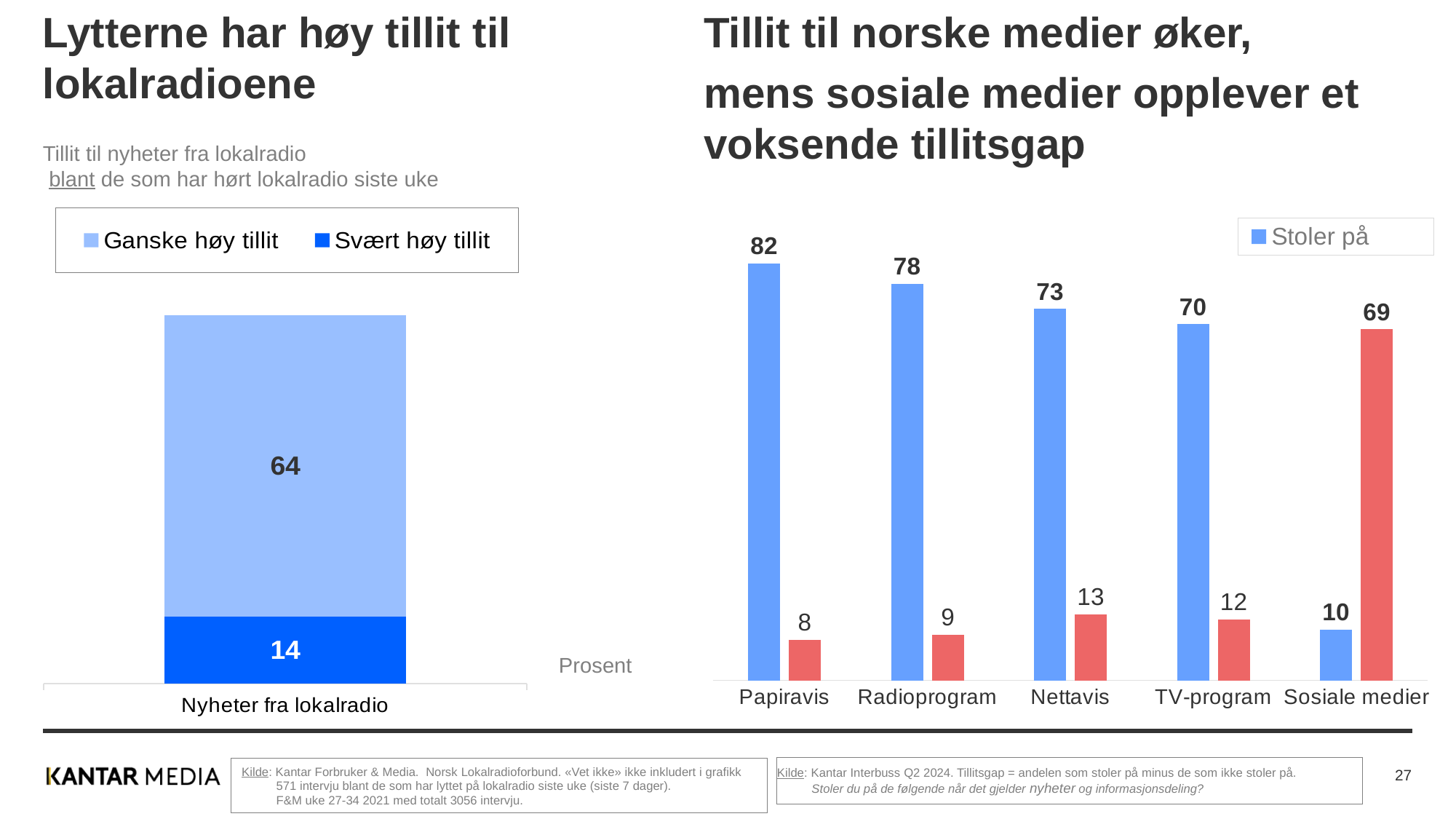
In the right chart (Tillit til norske medier øker), which category has the highest Stoler på value? Papiravis In the left chart (Tillit til nyheter fra lokalradio), what is the value for Ganske høy tillit? 64 In the right chart (Tillit til norske medier øker), how many categories are shown on the x axis? 5 In the left chart (Tillit til nyheter fra lokalradio), how many series does the legend list? 2 In the left chart (Tillit til nyheter fra lokalradio), what is the value for Svært høy tillit? 14 In the right chart (Tillit til norske medier øker), what is the Stoler på value for Sosiale medier? 10 In the right chart (Tillit til norske medier øker), what is the Stoler på value for Papiravis? 82 In the right chart (Tillit til norske medier øker), what is the difference between the Stoler på values for Papiravis and Radioprogram? 4 What kind of chart is the right chart (Tillit til norske medier øker)? Bar chart In the right chart (Tillit til norske medier øker), what is the value of the red bar for Sosiale medier? 69 In the right chart (Tillit til norske medier øker), which category has the lowest Stoler på value? Sosiale medier In the left chart (Tillit til nyheter fra lokalradio), what is the total of the stacked bar for Nyheter fra lokalradio? 78